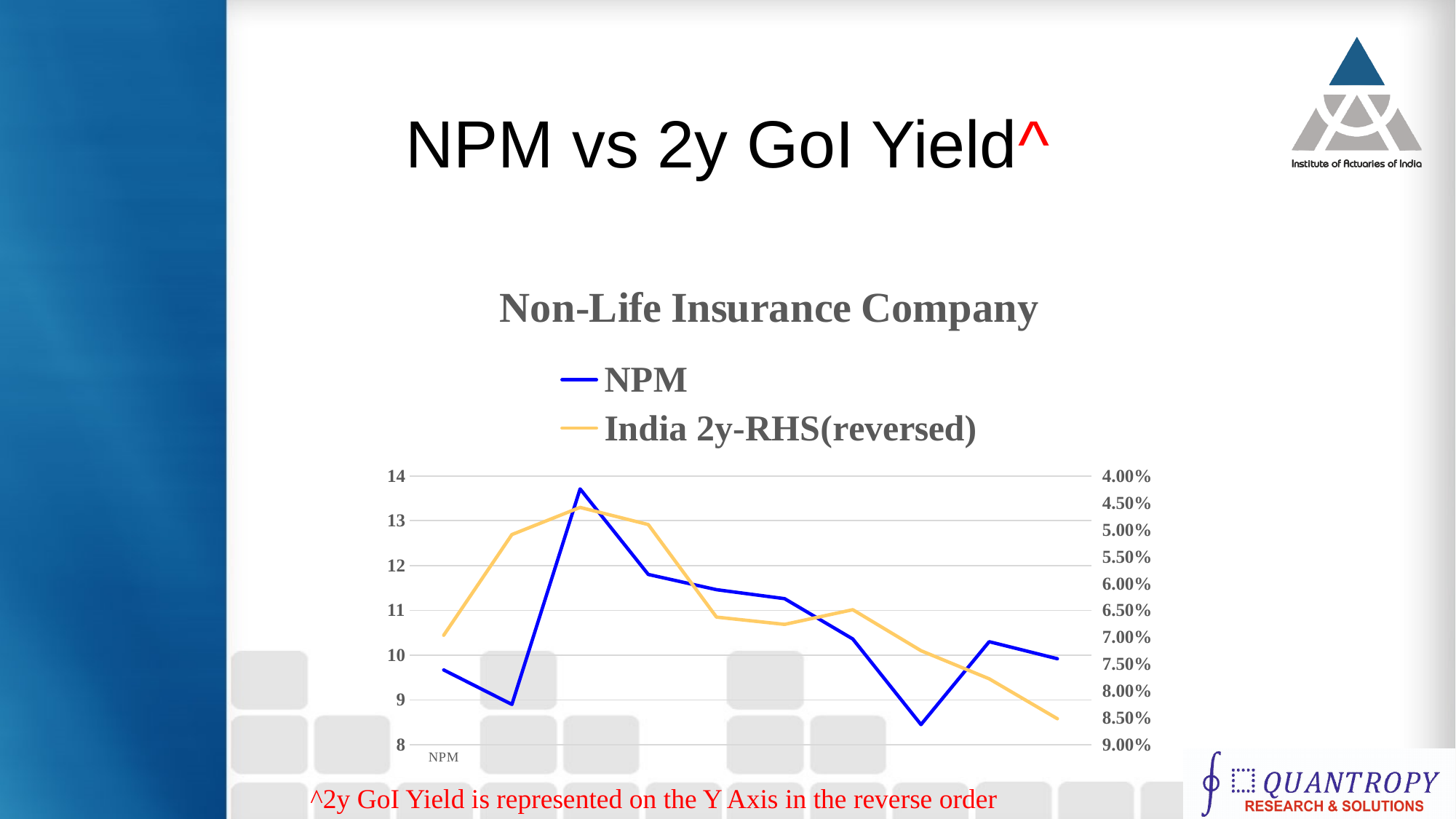
How many data points does the NPM line have? 10 Which series is drawn in blue? NPM Is the NPM value at its first point greater or less than 10? less Does the NPM line rise or fall between its third point and its eighth point? fall How many series does the chart legend list? 2 At which point along the x axis does the NPM line reach its highest value? the third point What is the title of the chart? Non-Life Insurance Company Is the India 2y-RHS(reversed) value at its last point greater or less than 8.00%? greater What kind of chart is shown on the slide? line chart Is the NPM value at its eighth point greater or less than 9? less At which point along the x axis does the NPM line reach its lowest value? the eighth point